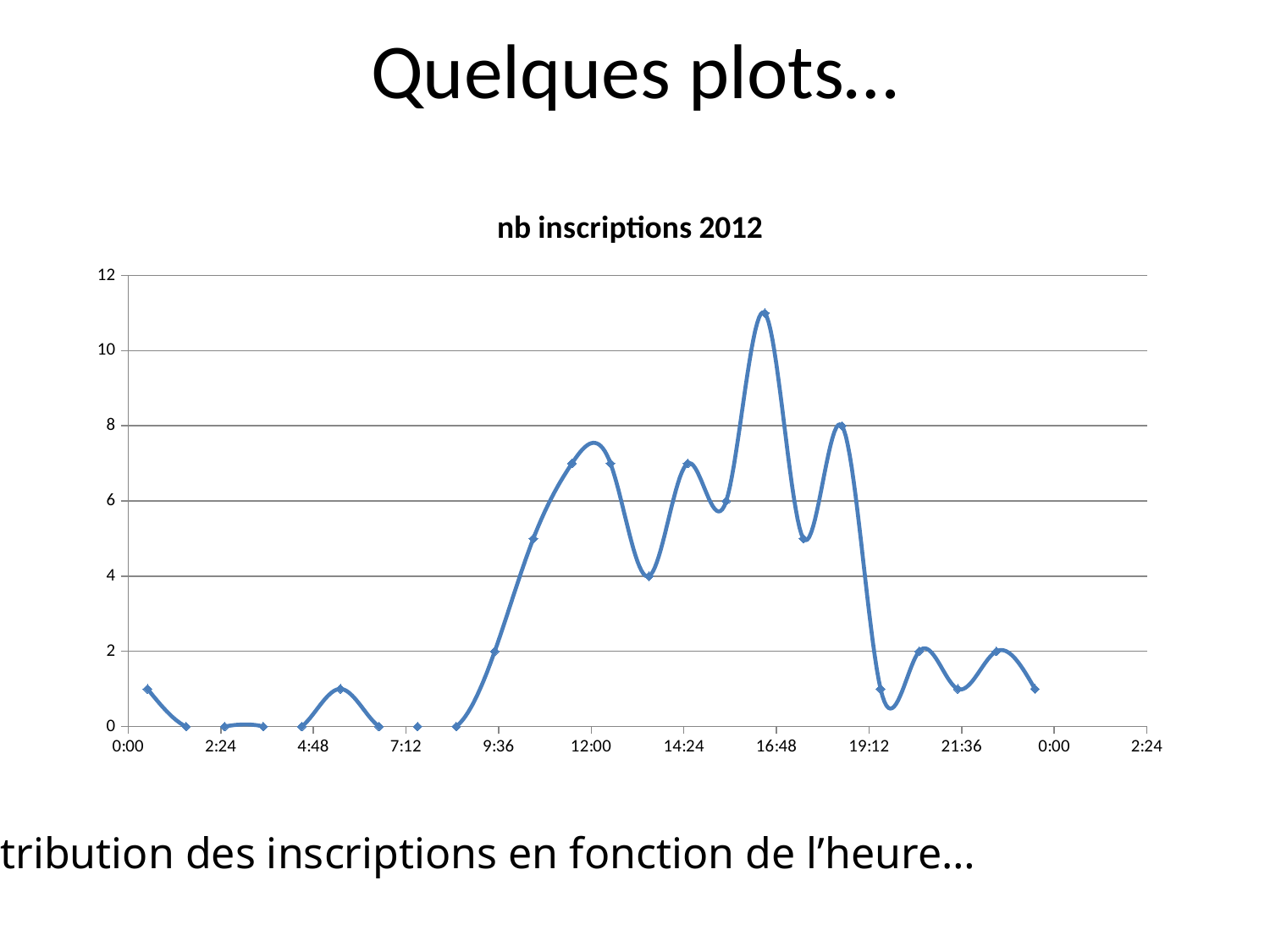
What type of chart is shown on the slide? line chart Is the highest point of the line greater or less than 10? greater Is the value of the line at 12:00 greater or less than 6? greater What is the title of the chart? nb inscriptions 2012 How many data series are plotted in the chart? 1 Is the value of the line at 9:36 greater or less than 4? less What is the highest value shown on the y axis? 12 From 7:12 to 12:00, does the line generally rise or fall? rise Which is higher: the peak just before 16:48 or the peak near 12:00? the peak just before 16:48 Between which two x-axis labels does the highest point of the line fall? 14:24 and 16:48